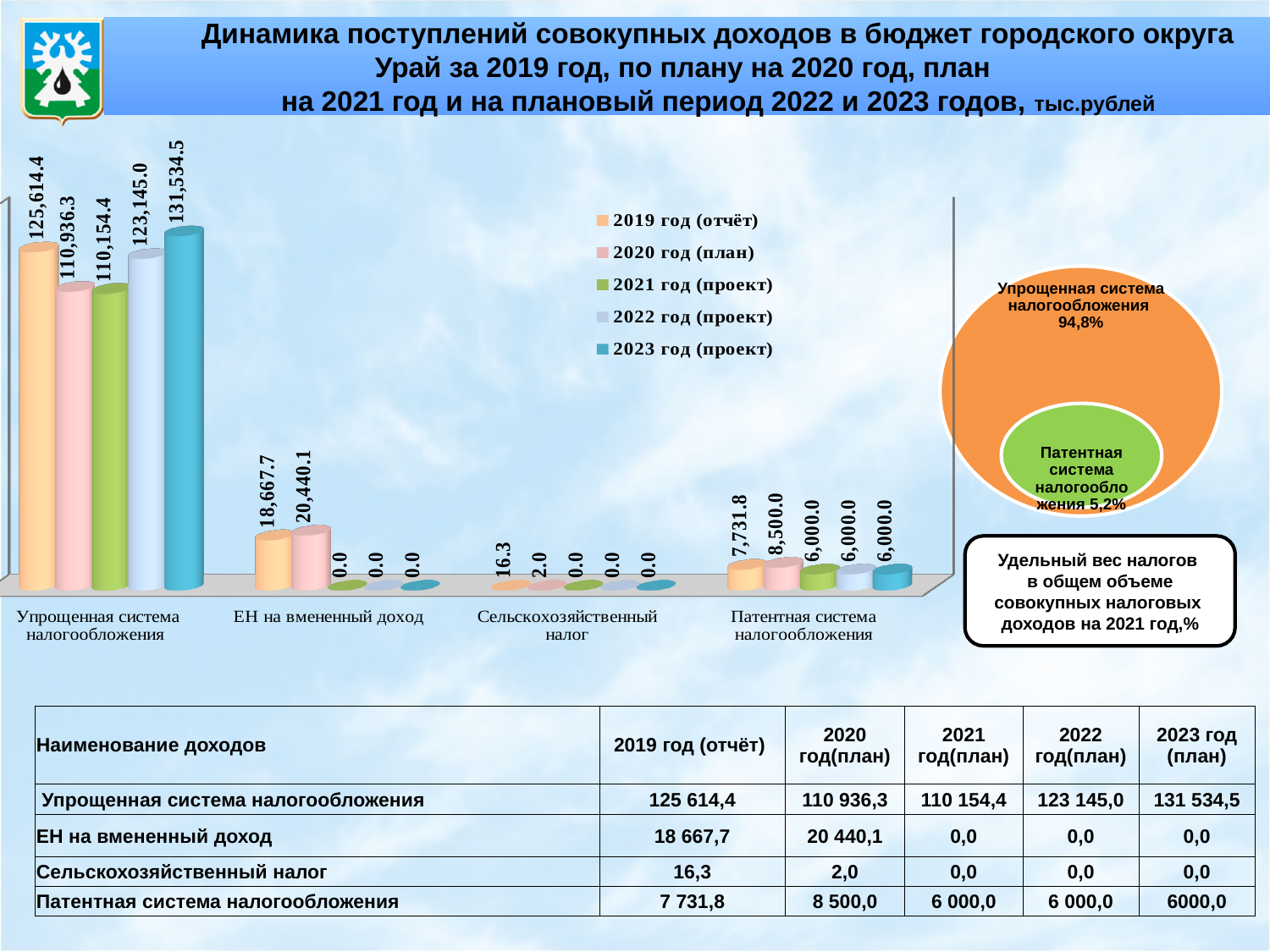
In the bar chart, what is the value for Упрощенная система налогообложения in 2023 год (проект)? 131,534.5 In the bar chart, which year has the lowest value for Упрощенная система налогообложения? 2021 год (проект) How many series does the legend of the bar chart list? 5 In the bar chart, what is the value for ЕН на вмененный доход in 2020 год (план)? 20,440.1 What kind of chart is the chart on the left of the slide? bar chart In the bar chart, which year has the highest value for Упрощенная система налогообложения? 2023 год (проект) In the bar chart, what is the difference between the 2020 год (план) and 2019 год (отчёт) values for ЕН на вмененный доход? 1,772.4 In the bar chart, which is larger for Патентная система налогообложения: the 2019 год (отчёт) value or the 2020 год (план) value? 2020 год (план) In the bar chart, what is the difference between the 2023 год (проект) and 2019 год (отчёт) values for Упрощенная система налогообложения? 5,920.1 In the diagram on the right, what share of total tax revenues in 2021 does Упрощенная система налогообложения account for? 94,8% How many categories are shown on the x axis of the bar chart? 4 In the bar chart, what is the value for Сельскохозяйственный налог in 2019 год (отчёт)? 16.3